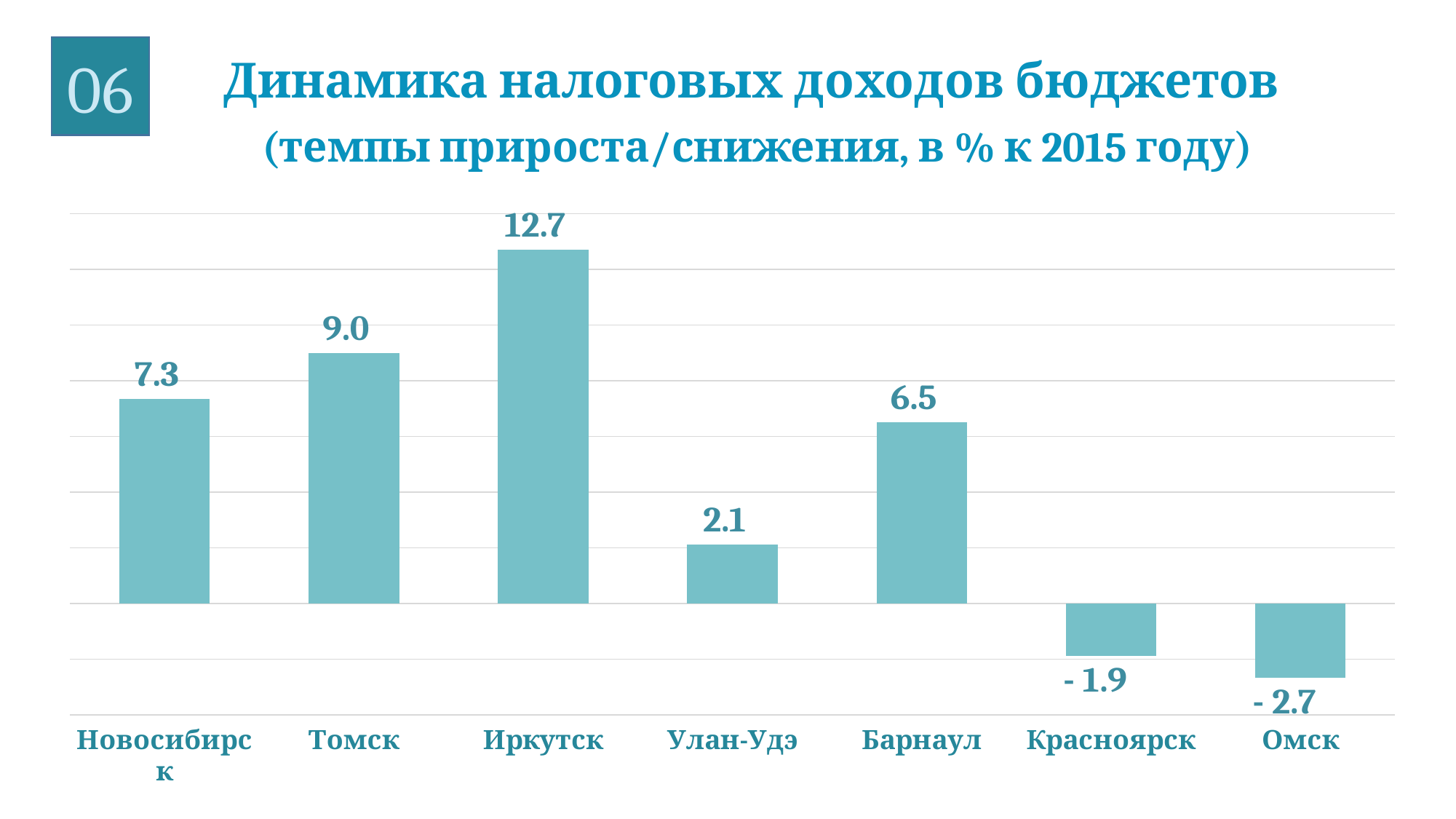
What is the difference between the values for Новосибирск and Барнаул? 0.8 What is the value for Иркутск? 12.7 Which city has the highest value? Иркутск What kind of chart is shown on the slide? Bar chart What is the difference between the values for Иркутск and Томск? 3.7 What is the value for Улан-Удэ? 2.1 What is the value for Омск? - 2.7 How many cities have negative values? 2 Which is larger, the value for Новосибирск or the value for Барнаул? Новосибирск How many cities are shown in the chart? 7 What is the value for Томск? 9.0 Which city has the lowest value? Омск